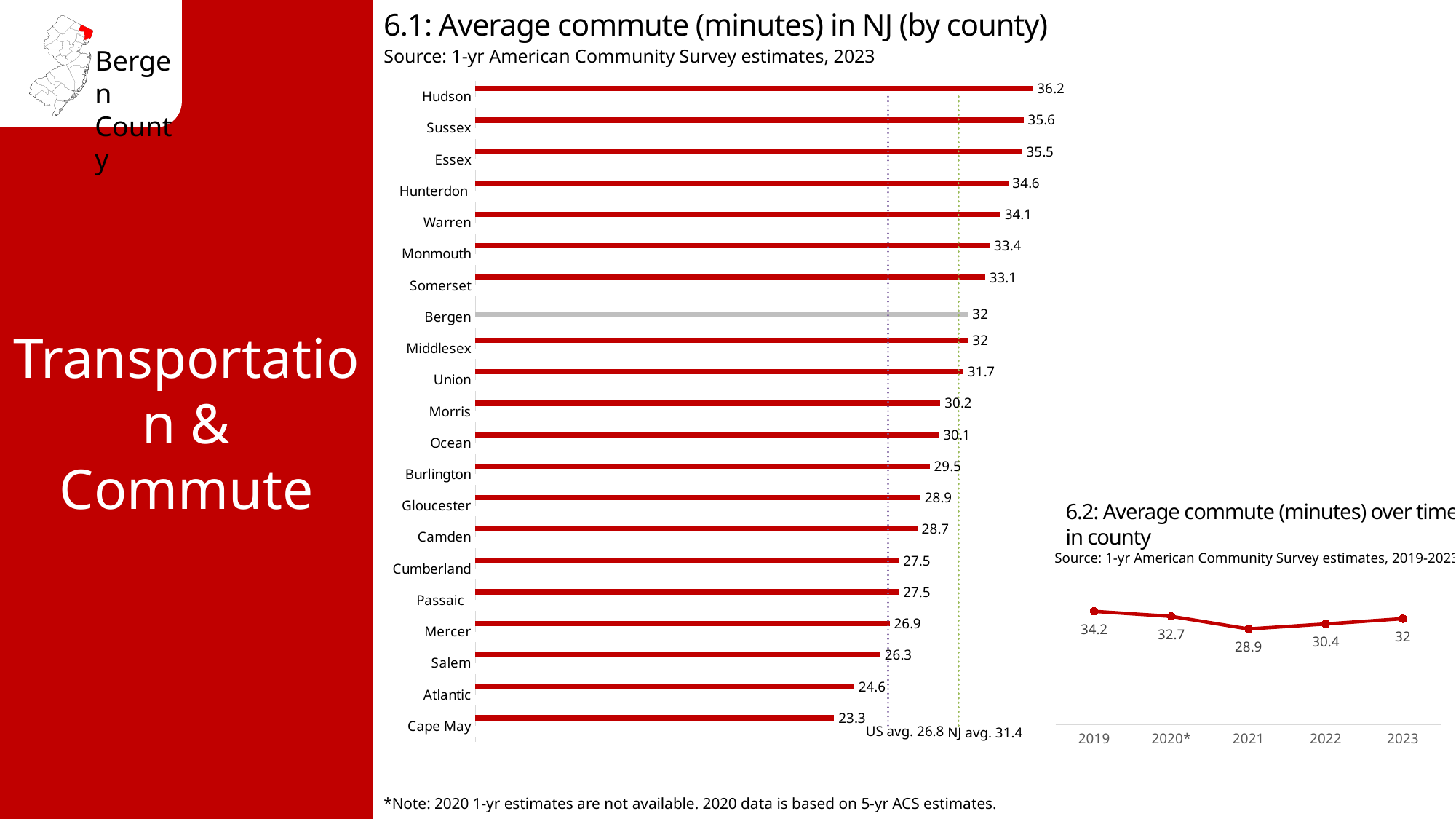
In chart 6.1, which county has a longer average commute, Morris or Camden? Morris In chart 6.1, what is the average commute in minutes for Hudson county? 36.2 In chart 6.1, how many counties are shown? 21 In chart 6.2, what was the average commute in minutes in 2019? 34.2 In chart 6.2, what is the difference in average commute minutes between 2019 and 2023? 2.2 In chart 6.1, which county has the highest average commute? Hudson In chart 6.1, which county has the lowest average commute? Cape May What kind of chart is chart 6.1? Bar chart In chart 6.1, what is the difference in average commute minutes between Hudson and Cape May? 12.9 In chart 6.1, what is the average commute in minutes for Bergen county? 32 In chart 6.2, which year had the lowest average commute? 2021 In chart 6.1, what is the NJ average commute shown by the dotted reference line? 31.4